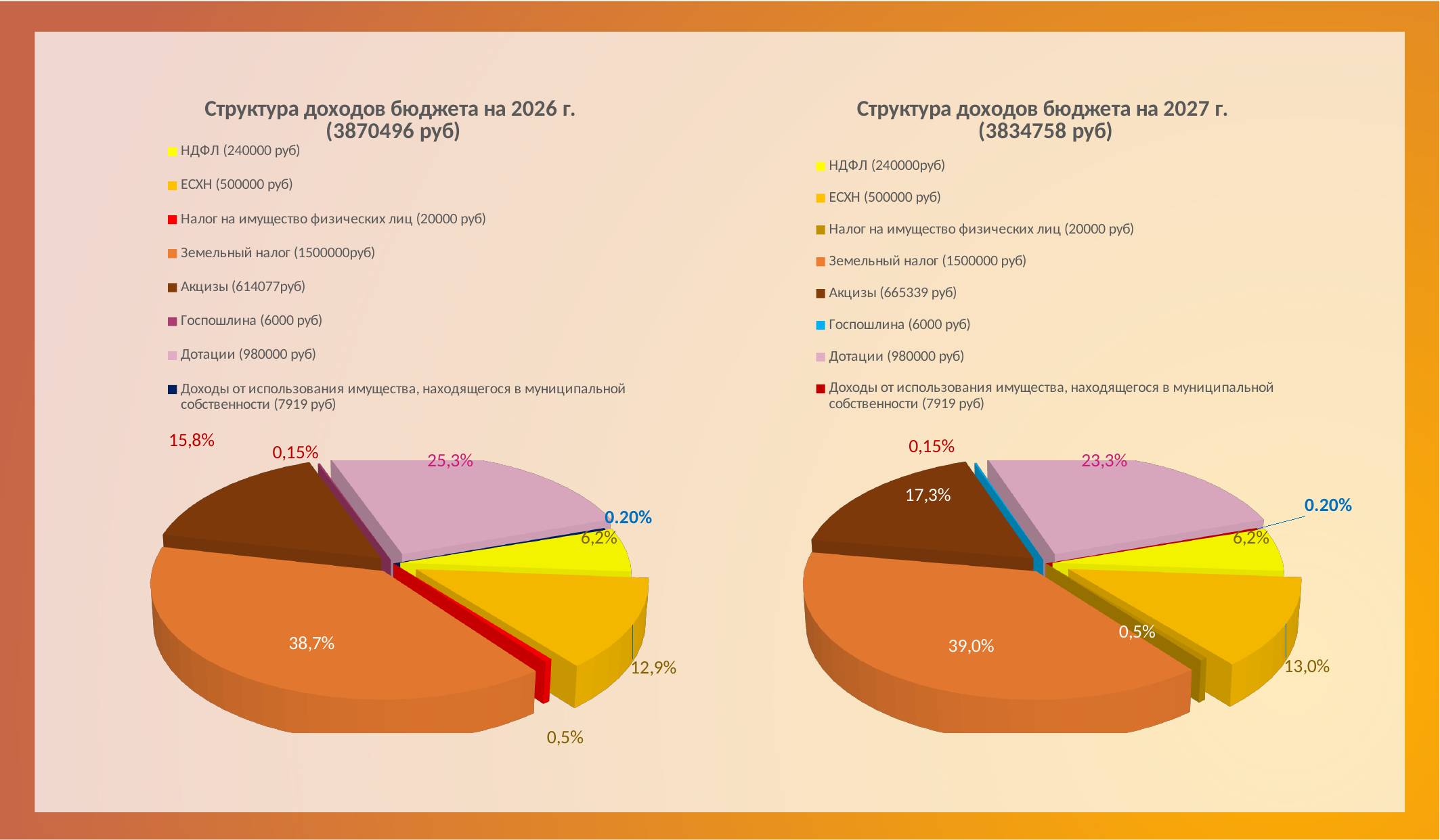
According to the legend of the 2026 chart, what amount is given for Акцизы? 614077руб In the 2026 chart, what share of the budget income is Земельный налог? 38,7% What kind of chart is used on the left for the 2026 budget income structure? pie chart In the 2027 chart, which category has the largest share? Земельный налог In the 2026 chart (Структура доходов бюджета на 2026 г.), how many categories does the legend list? 8 In the 2026 chart, what is the difference between the shares of Земельный налог (38,7%) and Дотации (25,3%)? 13,4% What total budget income is given in the title of the 2027 chart? 3834758 руб In the 2027 chart, which is larger: the share of Акцизы or the share of ЕСХН? Акцизы In the 2027 chart (Структура доходов бюджета на 2027 г.), what share is shown for Акцизы? 17,3% In the 2027 chart, what share is shown for ЕСХН? 13,0% In the 2026 chart, what share is shown for Дотации? 25,3% In the 2026 chart, which category has the smallest share? Госпошлина